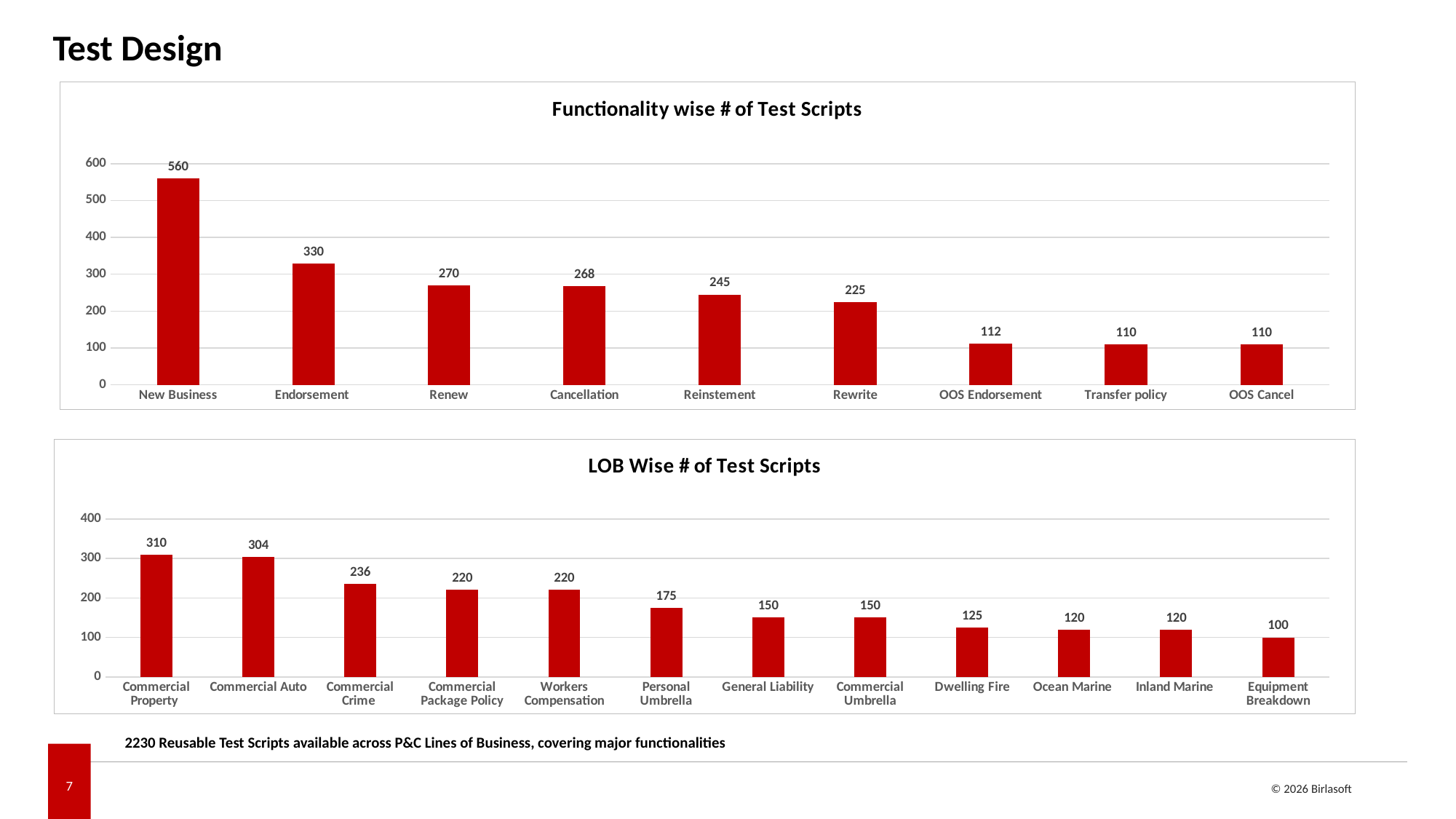
In the 'LOB Wise # of Test Scripts' chart, what is the value for Personal Umbrella? 175 In the 'Functionality wise # of Test Scripts' chart, how many categories are shown? 9 In the 'Functionality wise # of Test Scripts' chart, which category has the highest value? New Business What kind of chart is the 'LOB Wise # of Test Scripts' chart? Bar chart In the 'LOB Wise # of Test Scripts' chart, what is the difference between Commercial Property and Commercial Auto? 6 What colour are the bars in the 'Functionality wise # of Test Scripts' chart? Red In the 'Functionality wise # of Test Scripts' chart, what is the value for Endorsement? 330 In the 'LOB Wise # of Test Scripts' chart, which category has the lowest value? Equipment Breakdown In the 'LOB Wise # of Test Scripts' chart, do the values rise or fall from left to right? Fall In the 'Functionality wise # of Test Scripts' chart, which is larger, Reinstement or Rewrite? Reinstement In the 'LOB Wise # of Test Scripts' chart, how many categories are shown? 12 In the 'Functionality wise # of Test Scripts' chart, what is the difference between New Business and Renew? 290